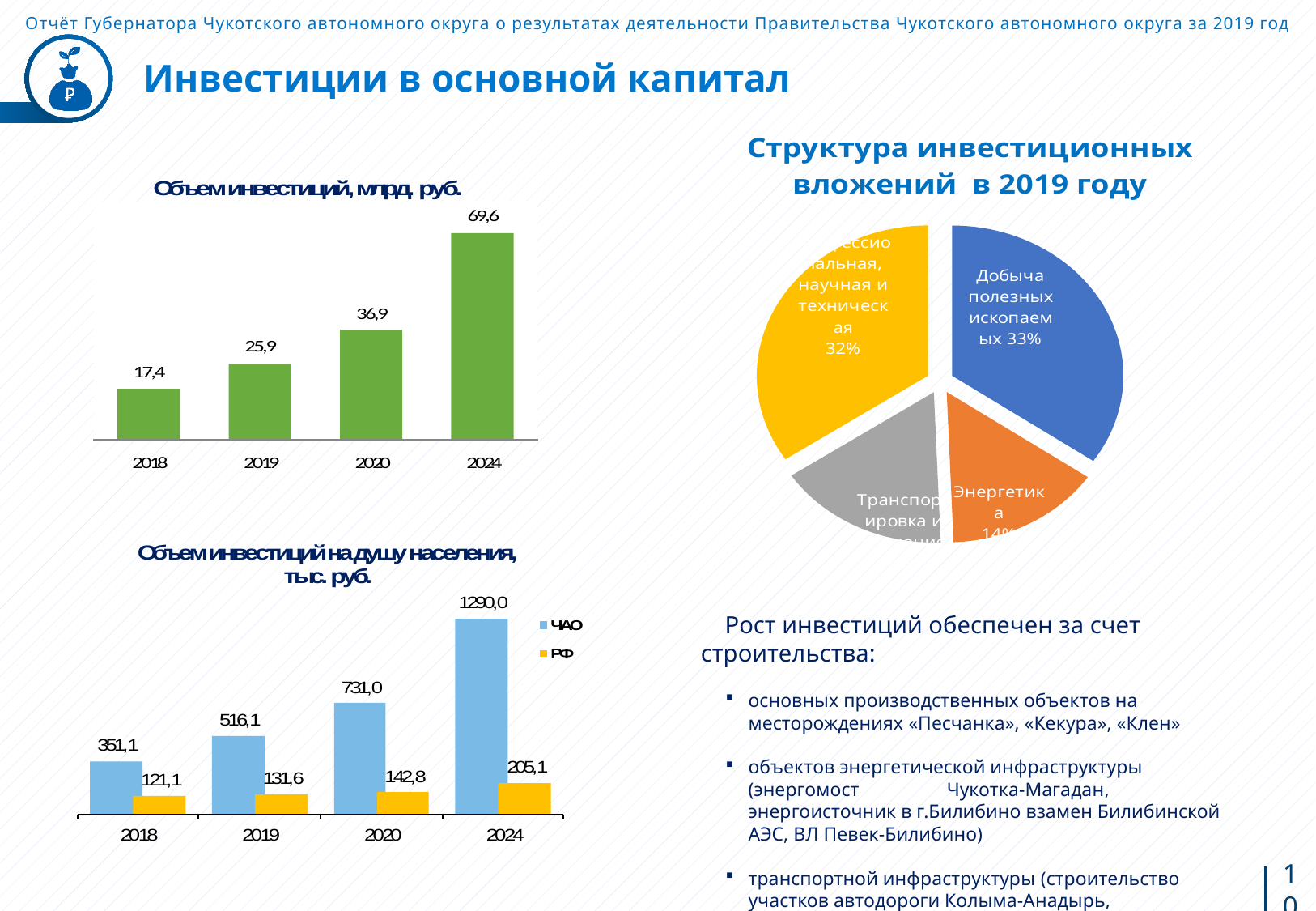
What kind of chart is 'Структура инвестиционных вложений в 2019 году'? pie chart In the chart 'Объем инвестиций, млрд. руб.', what is the difference between the 2020 and 2019 values? 11,0 In the chart 'Объем инвестиций, млрд. руб.', what is the value for 2018? 17,4 In the chart 'Объем инвестиций, млрд. руб.', how many years are shown? 4 In the chart 'Объем инвестиций, млрд. руб.', which year has the lowest value? 2018 In the chart 'Объем инвестиций на душу населения, тыс. руб.', what is the value for РФ in 2024? 205,1 In the chart 'Объем инвестиций, млрд. руб.', do the values rise or fall from 2018 to 2024? rise In the pie chart 'Структура инвестиционных вложений в 2019 году', what share does 'Добыча полезных ископаемых' have? 33% In the chart 'Объем инвестиций на душу населения, тыс. руб.', which is larger in 2018: ЧАО or РФ? ЧАО In the chart 'Объем инвестиций на душу населения, тыс. руб.', what is the value for ЧАО in 2020? 731,0 In the chart 'Объем инвестиций, млрд. руб.', what is the value for 2024? 69,6 In the chart 'Объем инвестиций на душу населения, тыс. руб.', how many series does the legend list? 2